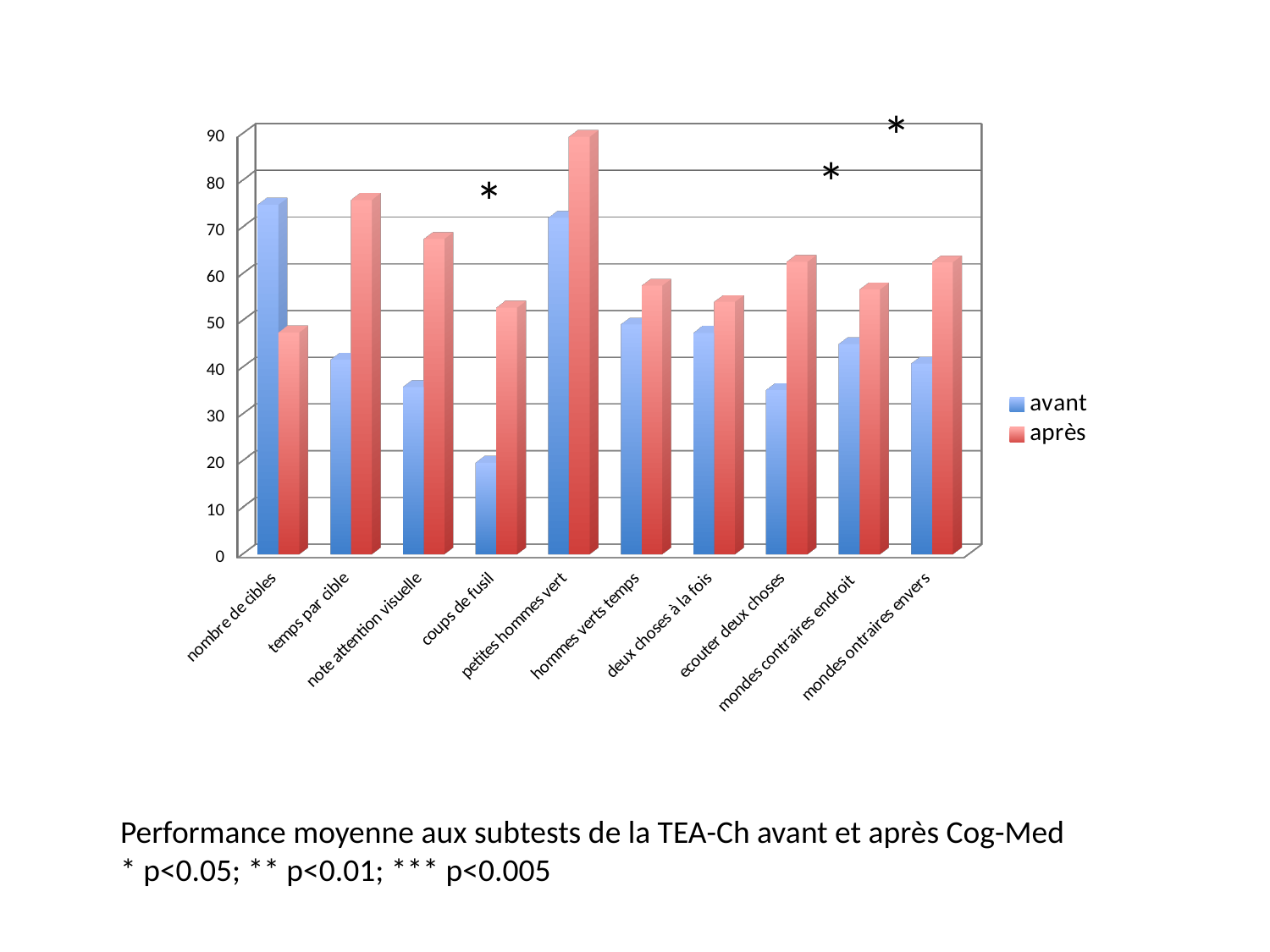
What kind of chart is shown on the slide? bar chart How many subtest categories are shown on the x axis? 10 Which category has the lowest 'avant' value? coups de fusil Is the 'après' value for 'petites hommes vert' greater or less than 80? greater Which category has the highest 'après' value? petites hommes vert For 'temps par cible', which is larger, the 'avant' value or the 'après' value? après What are the two series named in the legend? avant and après For 'nombre de cibles', which is larger, the 'avant' value or the 'après' value? avant How many series does the legend list? 2 Is the 'après' value for 'note attention visuelle' greater or less than 60? greater Is the 'avant' value for 'ecouter deux choses' greater or less than 40? less